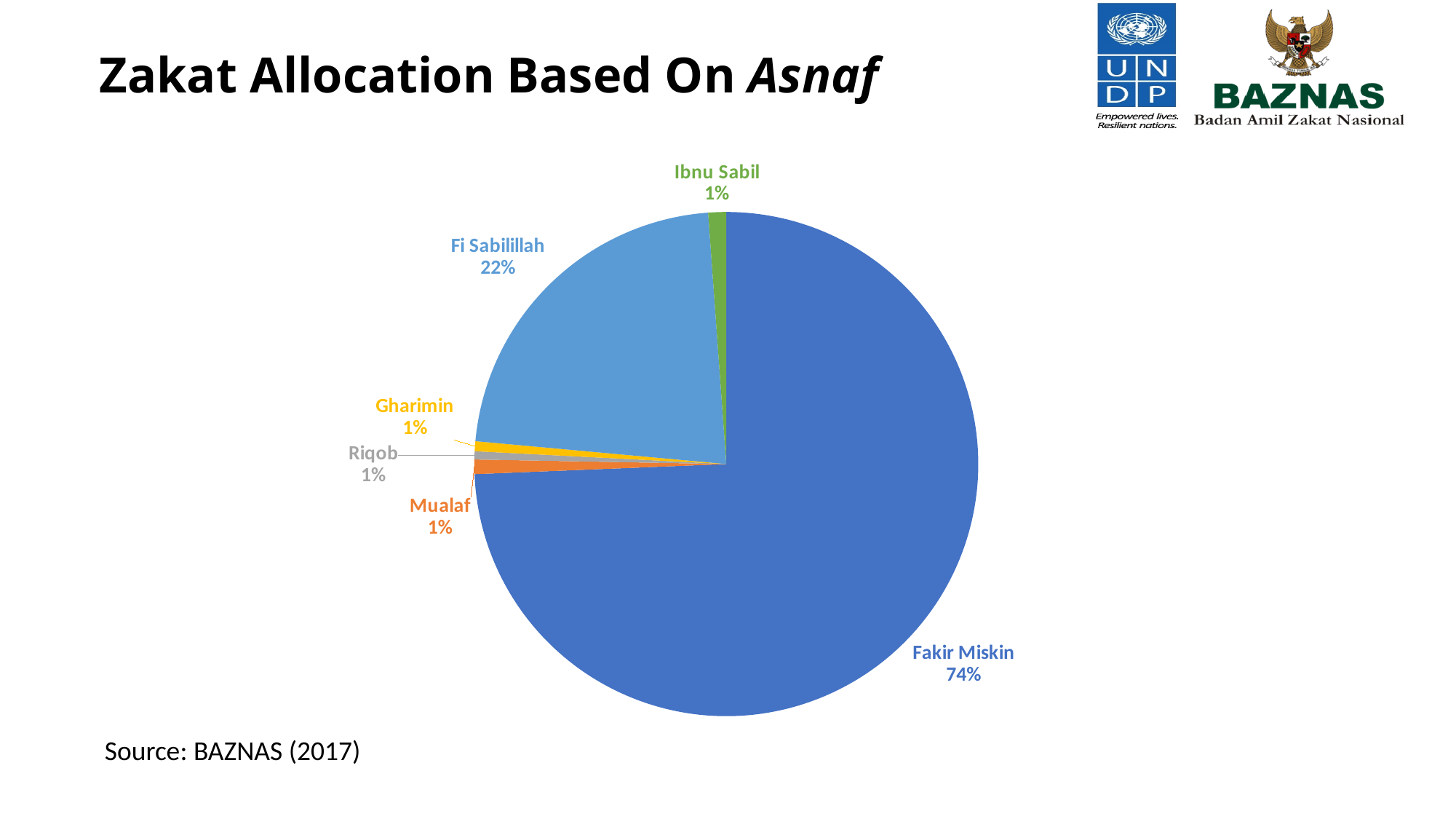
What source is cited for the chart data? BAZNAS (2017) What percentage is shown for Mualaf? 1% Which is larger, the share for Fi Sabilillah or the share for Riqob? Fi Sabilillah What share of zakat allocation goes to Fakir Miskin? 74% How many categories are shown in the pie chart? 6 What is the difference in percentage points between Fakir Miskin and Fi Sabilillah? 52 What is the title of the slide containing the chart? Zakat Allocation Based On Asnaf Which category has the largest slice of the pie? Fakir Miskin What share of zakat allocation goes to Fi Sabilillah? 22% What percentage is shown for Ibnu Sabil? 1% What kind of chart is shown on the slide? Pie chart What percentage is shown for Gharimin? 1%